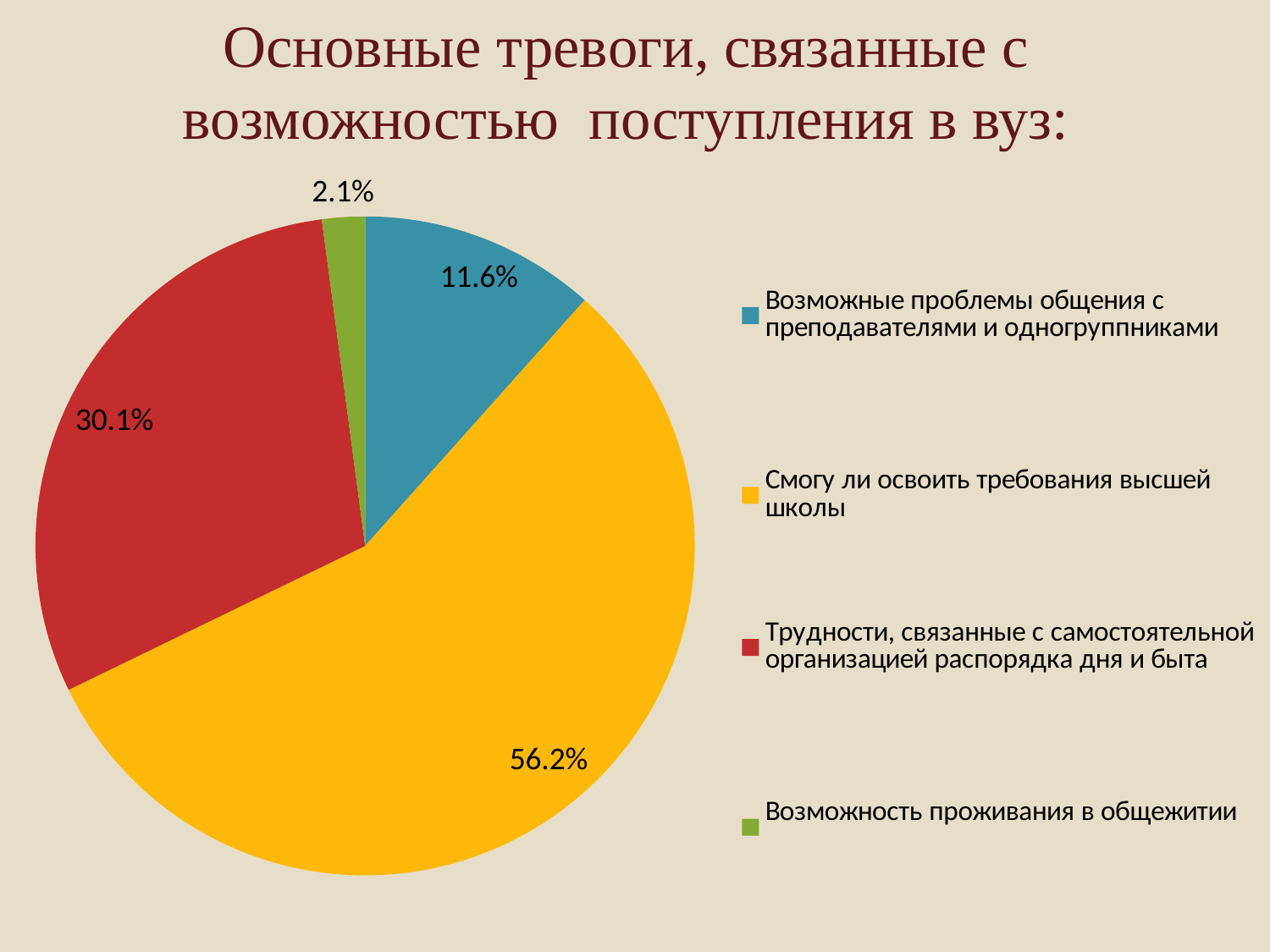
What is the value for "Возможность проживания в общежитии"? 2.1% What is the difference between the values for "Смогу ли освоить требования высшей школы" and "Трудности, связанные с самостоятельной организацией распорядка дня и быта"? 26.1% What colour is the slice for "Смогу ли освоить требования высшей школы"? yellow Which category has the smallest slice of the pie? Возможность проживания в общежитии What share of the pie is labelled "Смогу ли освоить требования высшей школы"? 56.2% What is the value for "Возможные проблемы общения с преподавателями и одногруппниками"? 11.6% How many categories does the pie chart show? 4 What type of chart is shown on the slide? pie chart Which is larger: the slice for "Возможные проблемы общения с преподавателями и одногруппниками" or the slice for "Трудности, связанные с самостоятельной организацией распорядка дня и быта"? Трудности, связанные с самостоятельной организацией распорядка дня и быта Which category has the largest slice of the pie? Смогу ли освоить требования высшей школы What is the title of the chart on the slide? Основные тревоги, связанные с возможностью поступления в вуз: What is the value for "Трудности, связанные с самостоятельной организацией распорядка дня и быта"? 30.1%